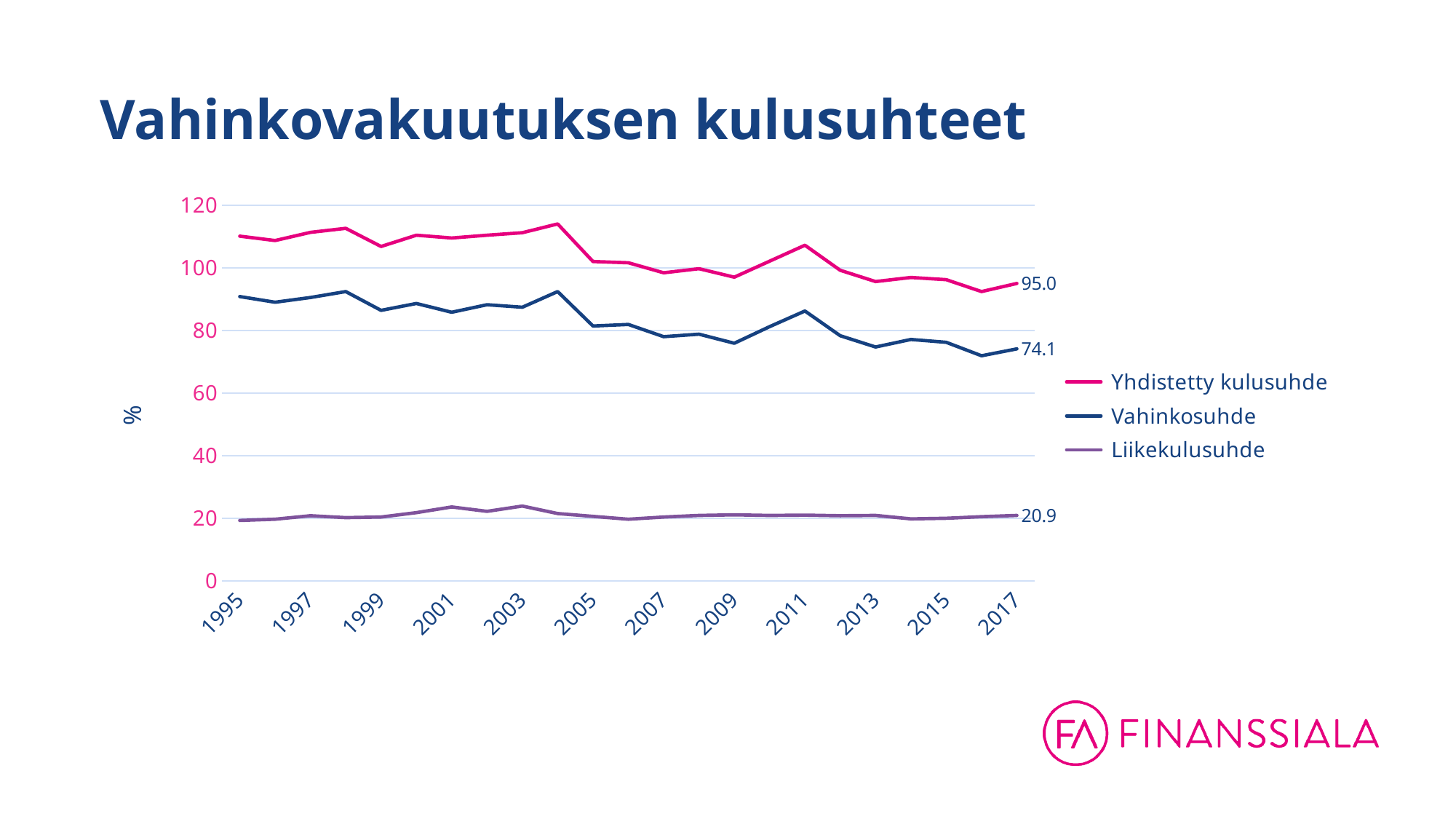
What is the difference between Yhdistetty kulusuhde and Vahinkosuhde in 2017? 20.9 What is the value of Vahinkosuhde in 2017? 74.1 What type of chart is shown on the slide? line chart Is the value for Vahinkosuhde in 2017 greater or less than 80? less Does Yhdistetty kulusuhde generally rise or fall from 1995 to 2017? fall How many series does the legend list? 3 Which series has the lowest values across the whole period? Liikekulusuhde Which is larger in 2017, Vahinkosuhde or Liikekulusuhde? Vahinkosuhde What is the title of the chart? Vahinkovakuutuksen kulusuhteet What is the value of Liikekulusuhde in 2017? 20.9 Is the value for Yhdistetty kulusuhde in 1995 greater or less than 100? greater What is the value of Yhdistetty kulusuhde in 2017? 95.0